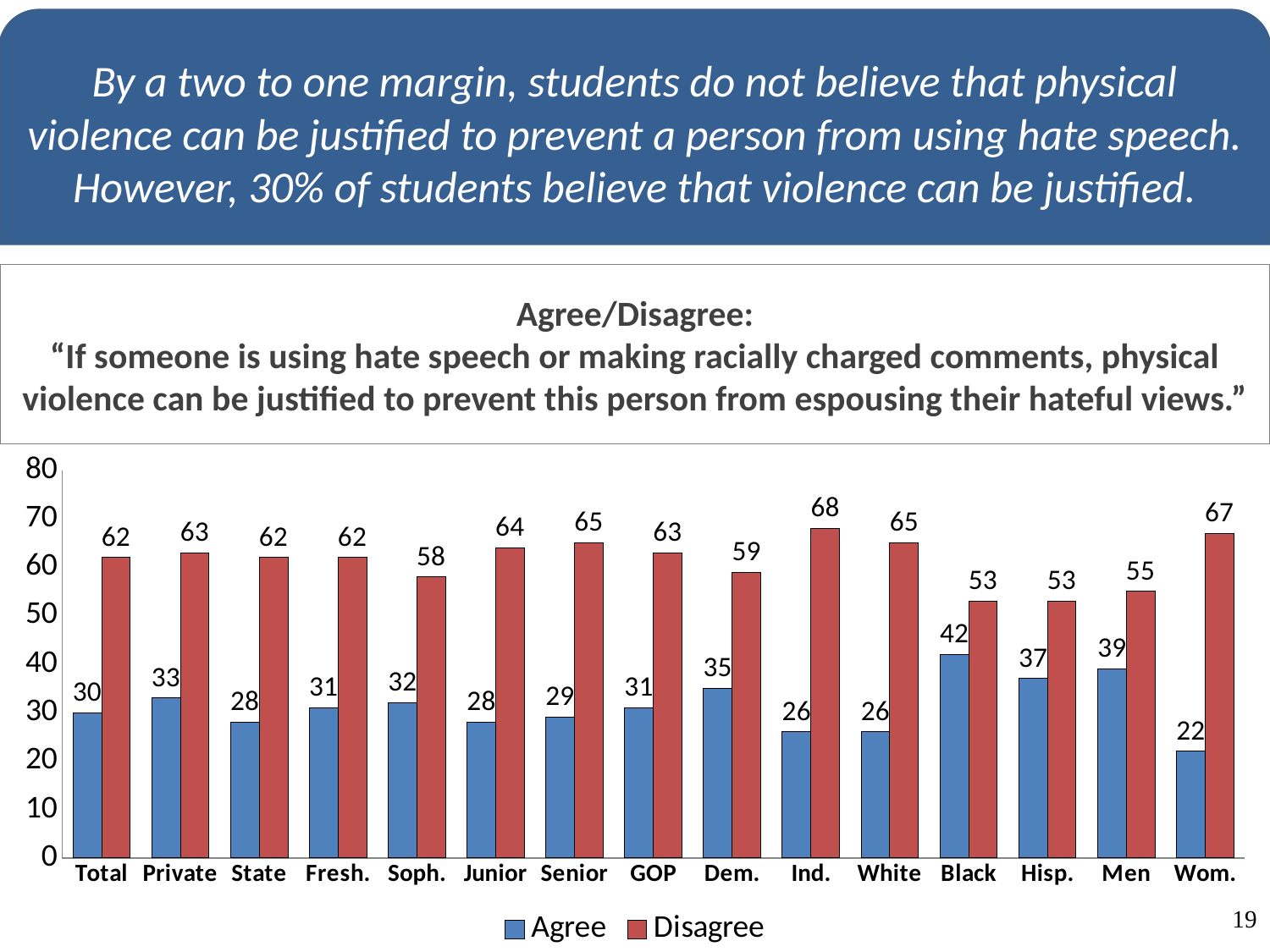
What is the Disagree value for Ind.? 68 How many categories are shown on the x axis? 15 What is the Agree value for Total? 30 Which category has the lowest Agree value? Wom. Which category has the highest Agree value? Black Which is larger, the Agree value for Black or the Agree value for Wom.? Black What is the difference between the Disagree and Agree values for Total? 32 What is the Disagree value for Soph.? 58 How many series does the legend list? 2 What is the Agree value for Wom.? 22 Which category has the highest Disagree value? Ind. What kind of chart is shown on the slide? Bar chart